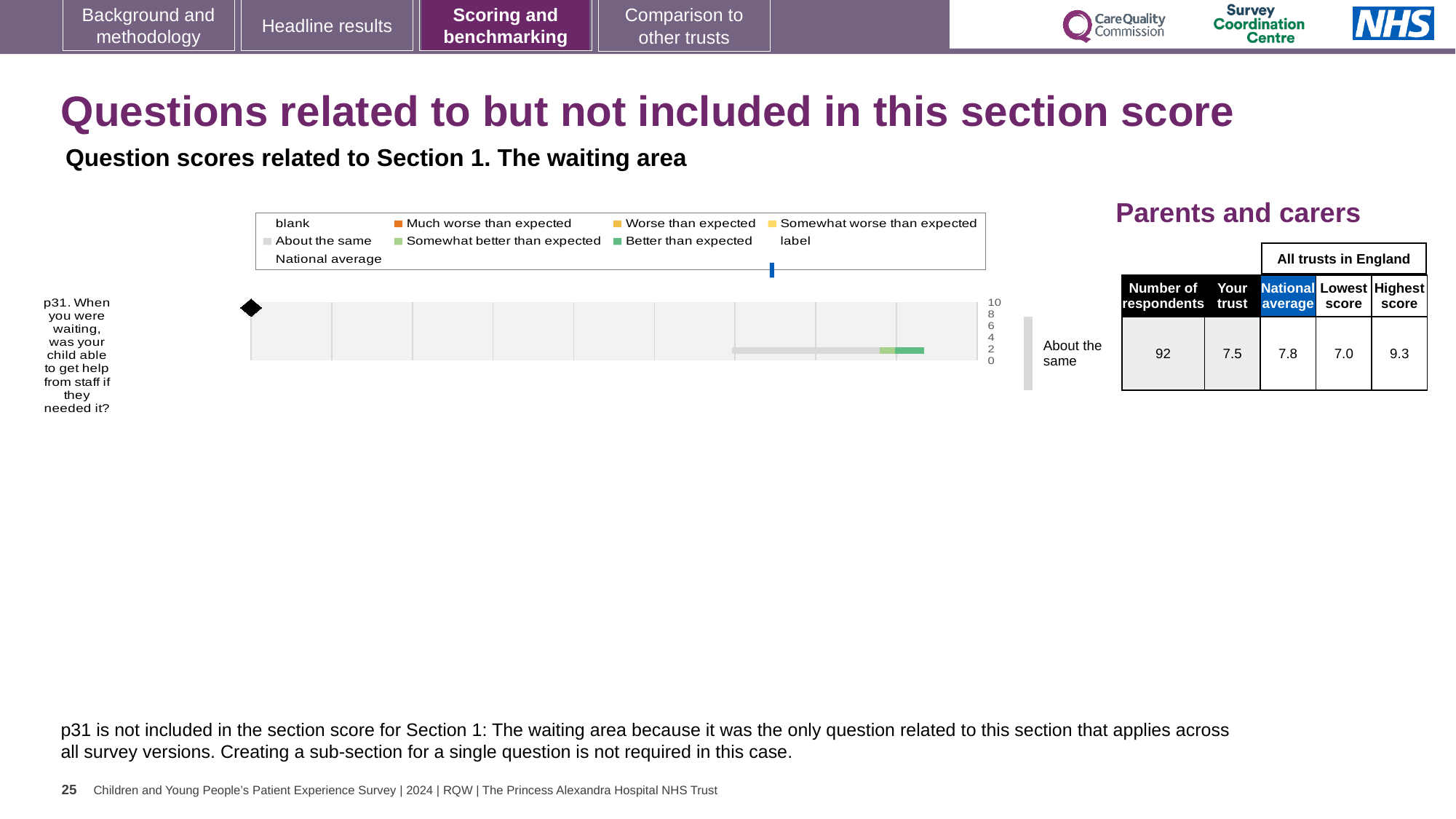
In the Parents and carers table, what is the Highest score among all trusts in England for p31? 9.3 In the Parents and carers table, what is the Lowest score among all trusts in England for p31? 7.0 What benchmark category is shown next to the chart for question p31? About the same For p31, what is the difference between the National average score and the Your trust score? 0.3 How many survey questions are plotted in the chart on this slide? 1 In the Parents and carers table, what is the National average score for p31? 7.8 In the Parents and carers table, how many respondents answered p31? 92 In the Parents and carers table, what is the Your trust score for p31? 7.5 For p31, what is the difference between the Highest score and the Lowest score among all trusts in England? 2.3 What kind of chart is shown on the slide for question p31? bar chart Which question is plotted in the chart on this slide? p31. When you were waiting, was your child able to get help from staff if they needed it? For p31, which is larger: the Your trust score or the National average score? National average